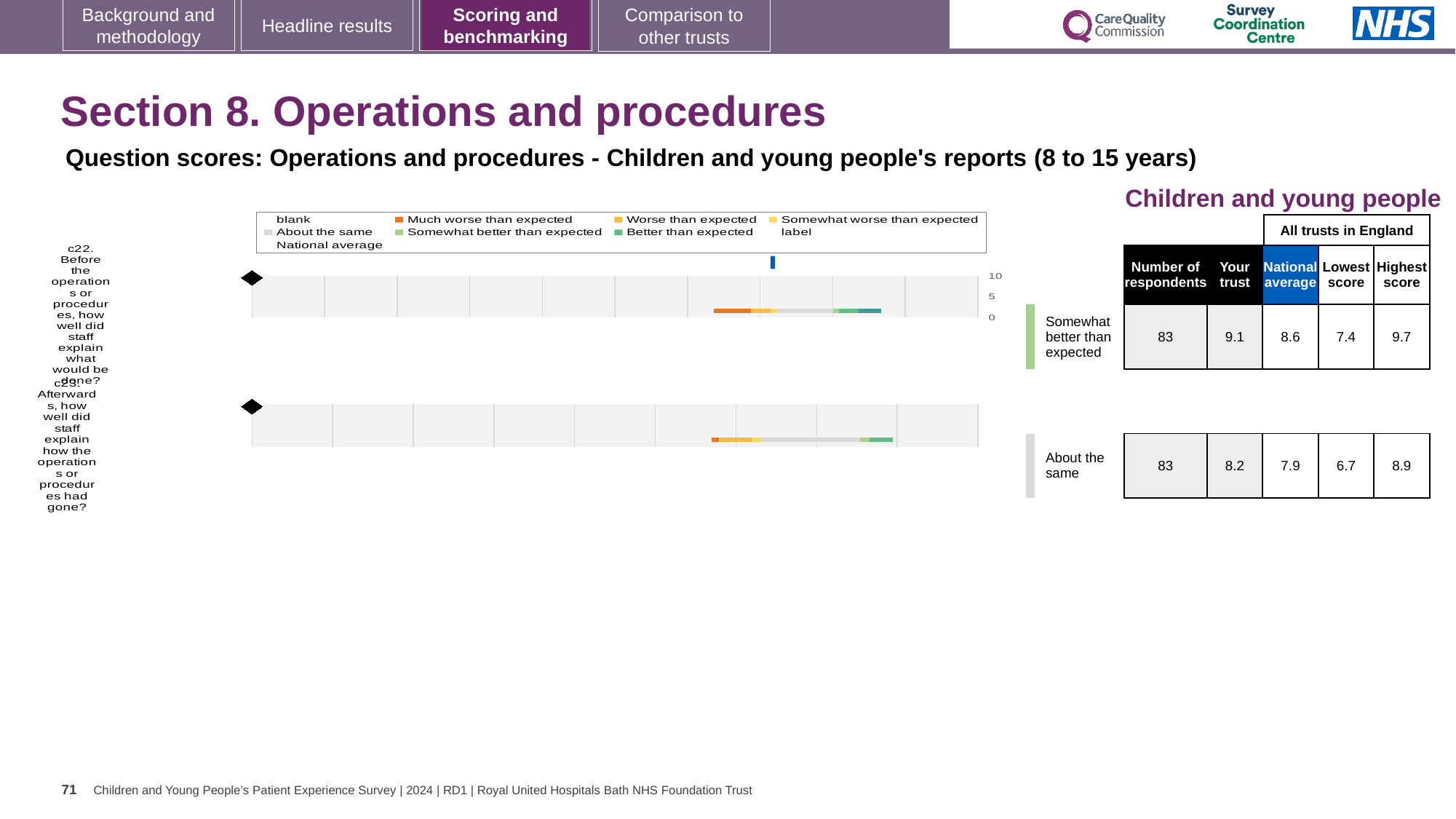
Which benchmark category is shown for question c22? Somewhat better than expected What is the 'Your trust' score for question c22 (how well staff explained what would be done before the operation)? 9.1 What is the 'Your trust' score for question c23 (how well staff explained how the operation had gone)? 8.2 For question c22, is the trust's score higher or lower than the national average? higher What is the lowest score among all trusts in England for question c22? 7.4 What is the difference between the trust's score and the national average for question c23? 0.3 What kind of chart is used to show the benchmark bands for questions c22 and c23? bar chart What is the national average score for question c22? 8.6 Which question has the higher 'Your trust' score, c22 or c23? c22 How many respondents answered question c22? 83 What is the highest score among all trusts in England for question c23? 8.9 How many survey questions (rows) are plotted on the slide? 2